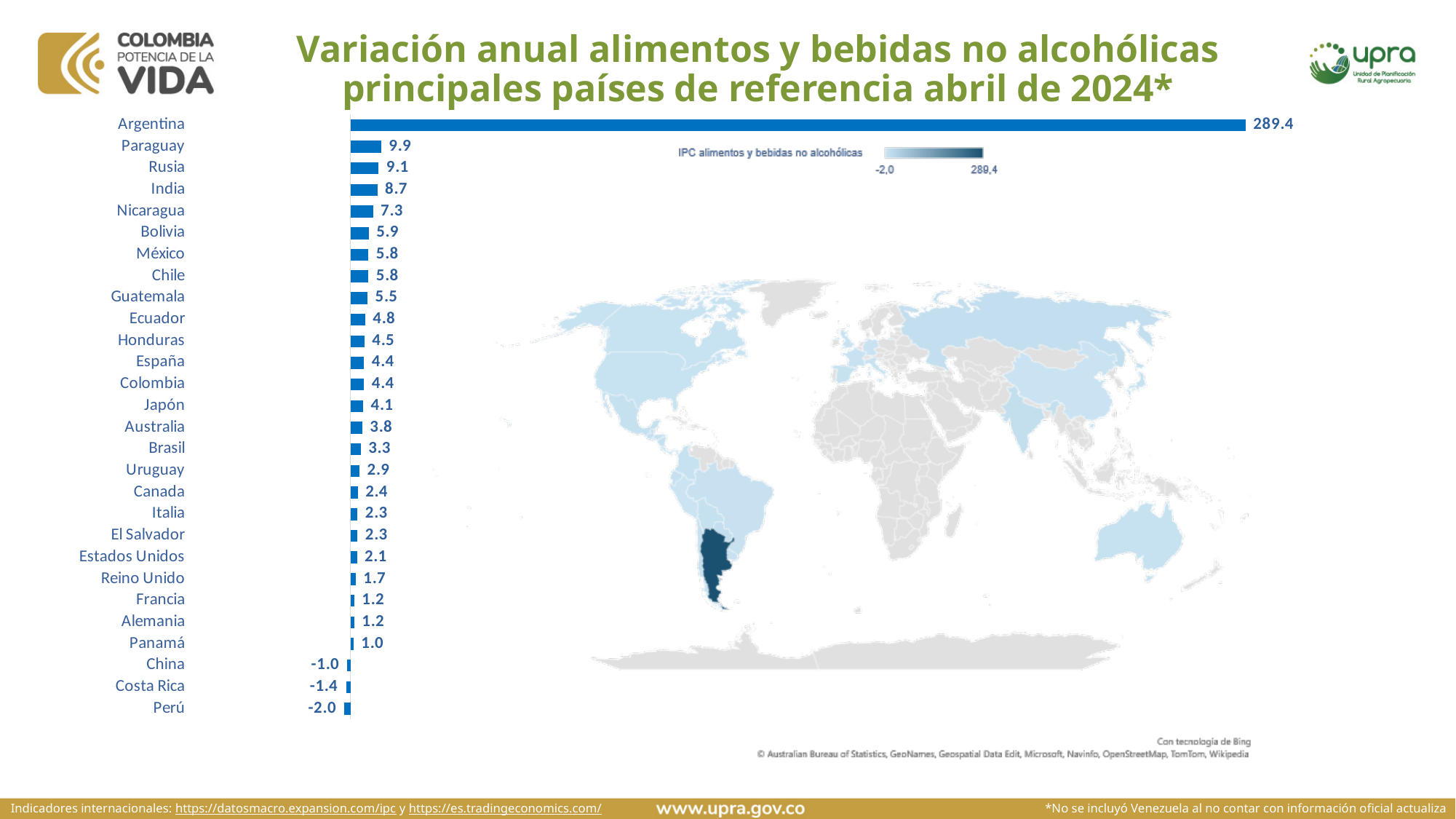
In the bar chart on the left, how many countries have a negative value? 3 In the bar chart on the left, what is the difference between the values for Paraguay and Rusia? 0.8 How many countries are shown in the bar chart on the left? 28 In the bar chart on the left, what is the value for Estados Unidos? 2.1 In the bar chart on the left, what is the value for Perú? -2.0 What kind of chart is shown on the left of the slide? Bar chart In the bar chart on the left, which country has the highest value? Argentina In the bar chart on the left, which country has the lowest value? Perú In the bar chart on the left, what is the value for Colombia? 4.4 In the bar chart on the left, what is the value for Argentina? 289.4 In the bar chart on the left, which has a larger value, Brasil or Uruguay? Brasil What is the title of the slide's chart? Variación anual alimentos y bebidas no alcohólicas principales países de referencia abril de 2024*